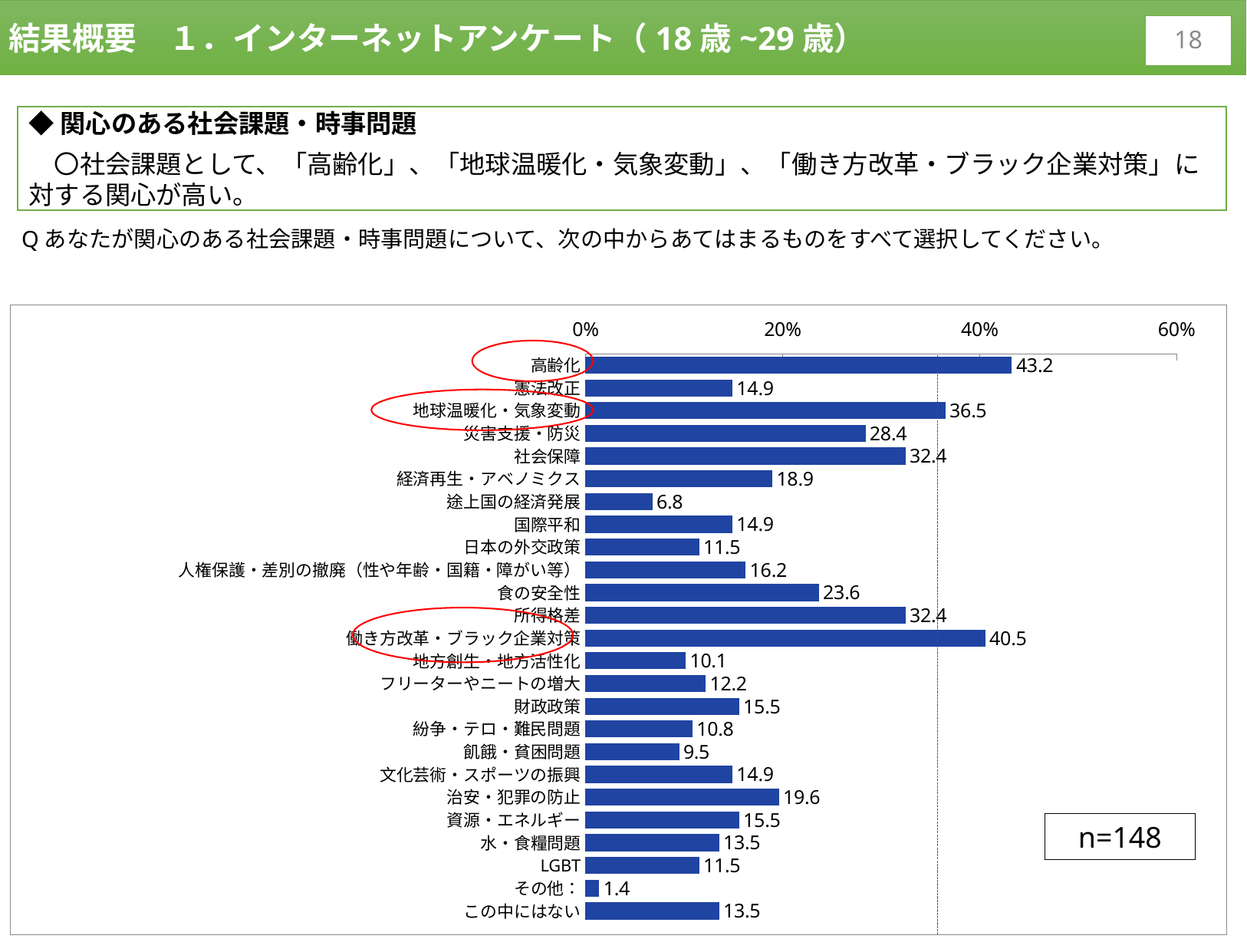
Which category has the highest value? 高齢化 How many categories are shown in the chart? 25 What type of chart is shown on the slide? bar chart Which is larger, the value for 災害支援・防災 or the value for 食の安全性? 災害支援・防災 Which category has the lowest value? その他 What is the value for LGBT? 11.5 What sample size (n) is shown on the chart? n=148 What is the value for 途上国の経済発展? 6.8 What is the value for 働き方改革・ブラック企業対策? 40.5 What is the value for 高齢化? 43.2 What is the value for 地球温暖化・気象変動? 36.5 What is the difference between the values for 高齢化 and 働き方改革・ブラック企業対策? 2.7